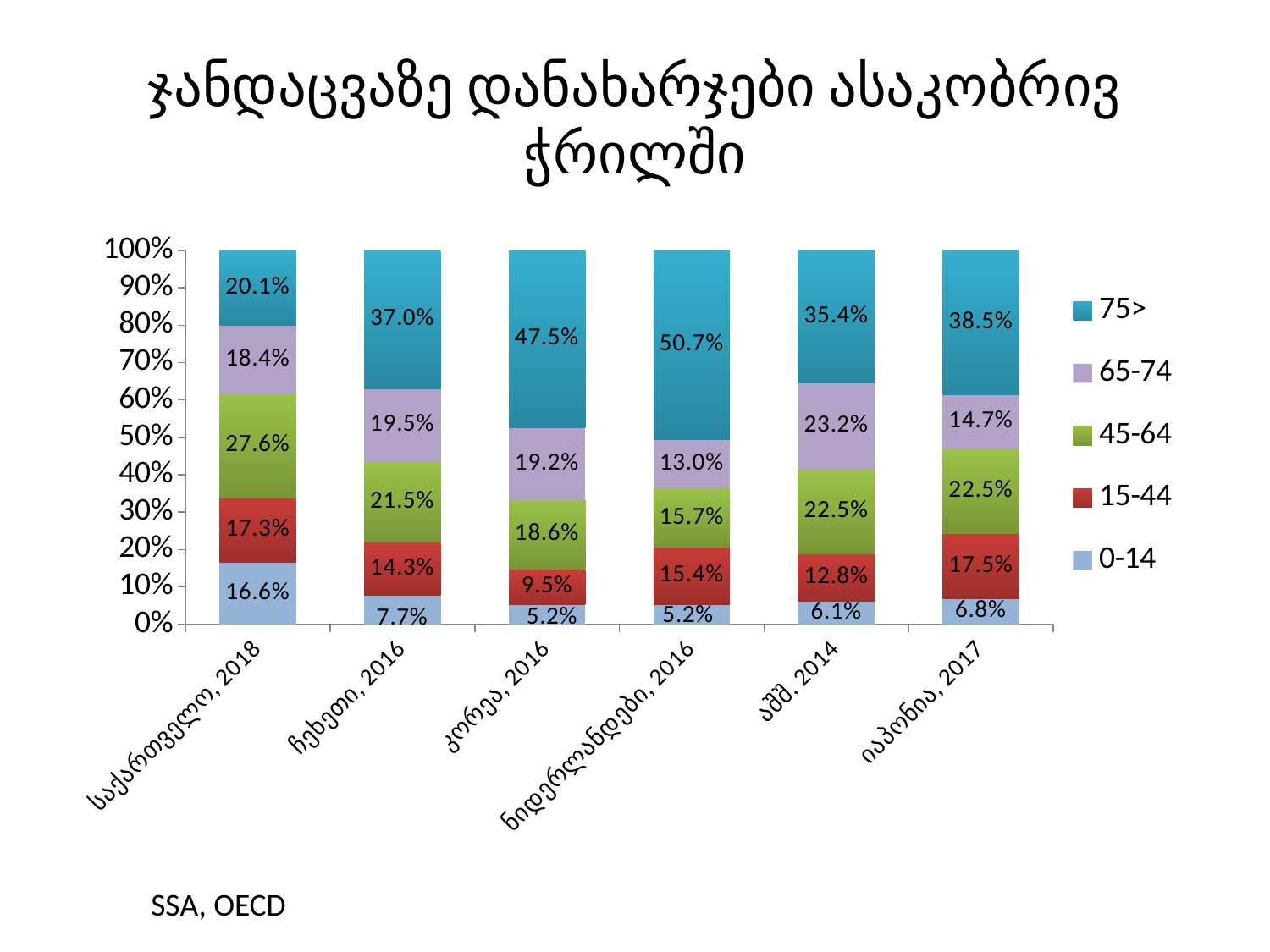
What kind of chart is shown on the slide? stacked bar chart How many series does the legend list? 5 Which category has the highest value for the 75> series? ნიდერლანდები, 2016 Which is larger: the 45-64 value for საქართველო, 2018 or the 45-64 value for იაპონია, 2017? საქართველო, 2018 Which category has the lowest value for the 15-44 series? კორეა, 2016 What is the value of the 65-74 series for აშშ, 2014? 23.2% How many categories are shown on the x axis? 6 What is the difference between the 75> values for კორეა, 2016 and ჩეხეთი, 2016? 10.5% What is the source text shown at the bottom of the slide? SSA, OECD What is the value of the 75> series for ნიდერლანდები, 2016? 50.7% What is the value of the 45-64 series for ჩეხეთი, 2016? 21.5% What is the value of the 0-14 series for საქართველო, 2018? 16.6%